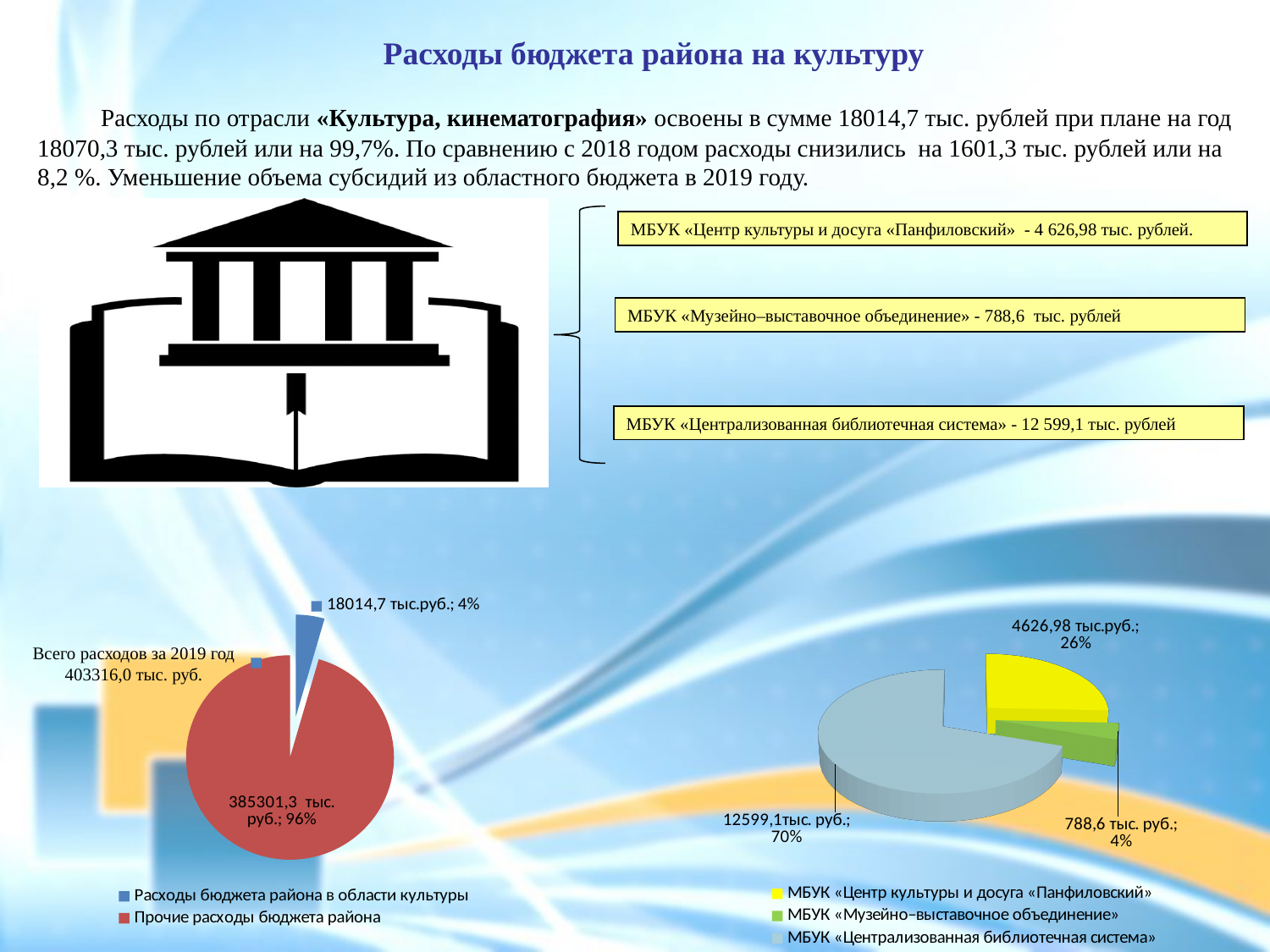
On the right pie chart, how many entries does the legend list? 3 On the left pie chart, how many slices are there? 2 On the right pie chart, what value is shown for МБУК «Централизованная библиотечная система»? 12599,1 тыс. руб.; 70% On the left pie chart, what share of the pie is «Прочие расходы бюджета района»? 96% On the left pie chart, what value is shown for «Прочие расходы бюджета района»? 385301,3 тыс. руб.; 96% On the right pie chart, which category has the smallest slice? МБУК «Музейно–выставочное объединение» On the right pie chart, what value is shown for МБУК «Музейно–выставочное объединение»? 788,6 тыс. руб.; 4% On the right pie chart, which category has the largest slice? МБУК «Централизованная библиотечная система» On the left pie chart, what value is shown for «Расходы бюджета района в области культуры»? 18014,7 тыс.руб.; 4% What kind of chart is the chart on the left of the slide? Pie chart On the right pie chart, which colour represents МБУК «Центр культуры и досуга «Панфиловский»? Yellow On the right pie chart, what share of the pie is МБУК «Центр культуры и досуга «Панфиловский»? 26%